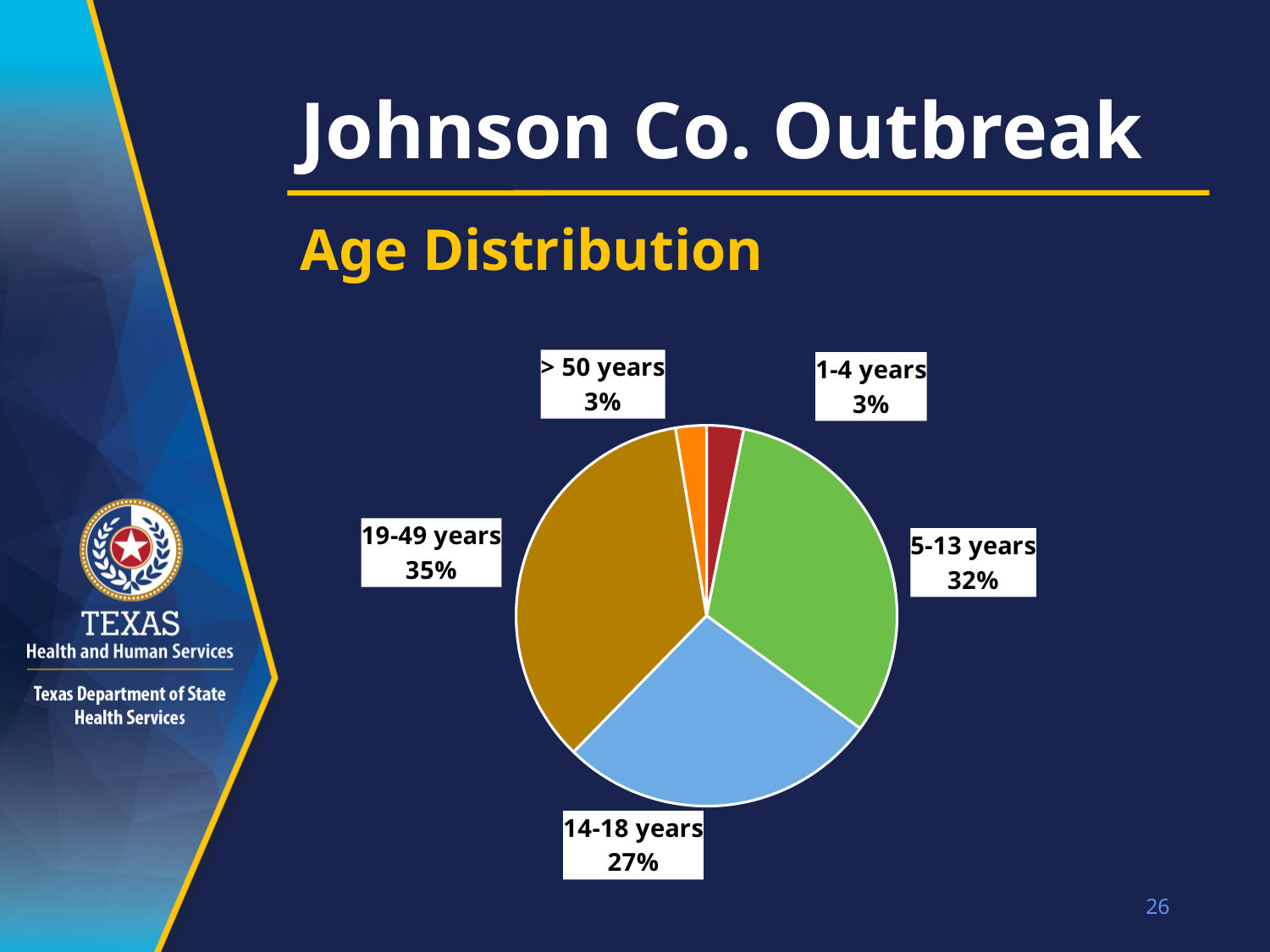
What is the value shown for the 1-4 years slice? 3% What is the subtitle of the chart on the slide? Age Distribution What is the value shown for the > 50 years slice? 3% What share of the pie does the 19-49 years slice represent? 35% How many slices does the pie chart have? 5 What is the value shown for the 14-18 years slice? 27% What is the difference between the shares for 19-49 years and 14-18 years? 8% What is the difference between the shares for 5-13 years and 1-4 years? 29% Which age group has the largest share of the pie? 19-49 years What kind of chart is shown on the slide? pie chart Which is larger, the share for 5-13 years or the share for 14-18 years? 5-13 years What is the value shown for the 5-13 years slice? 32%